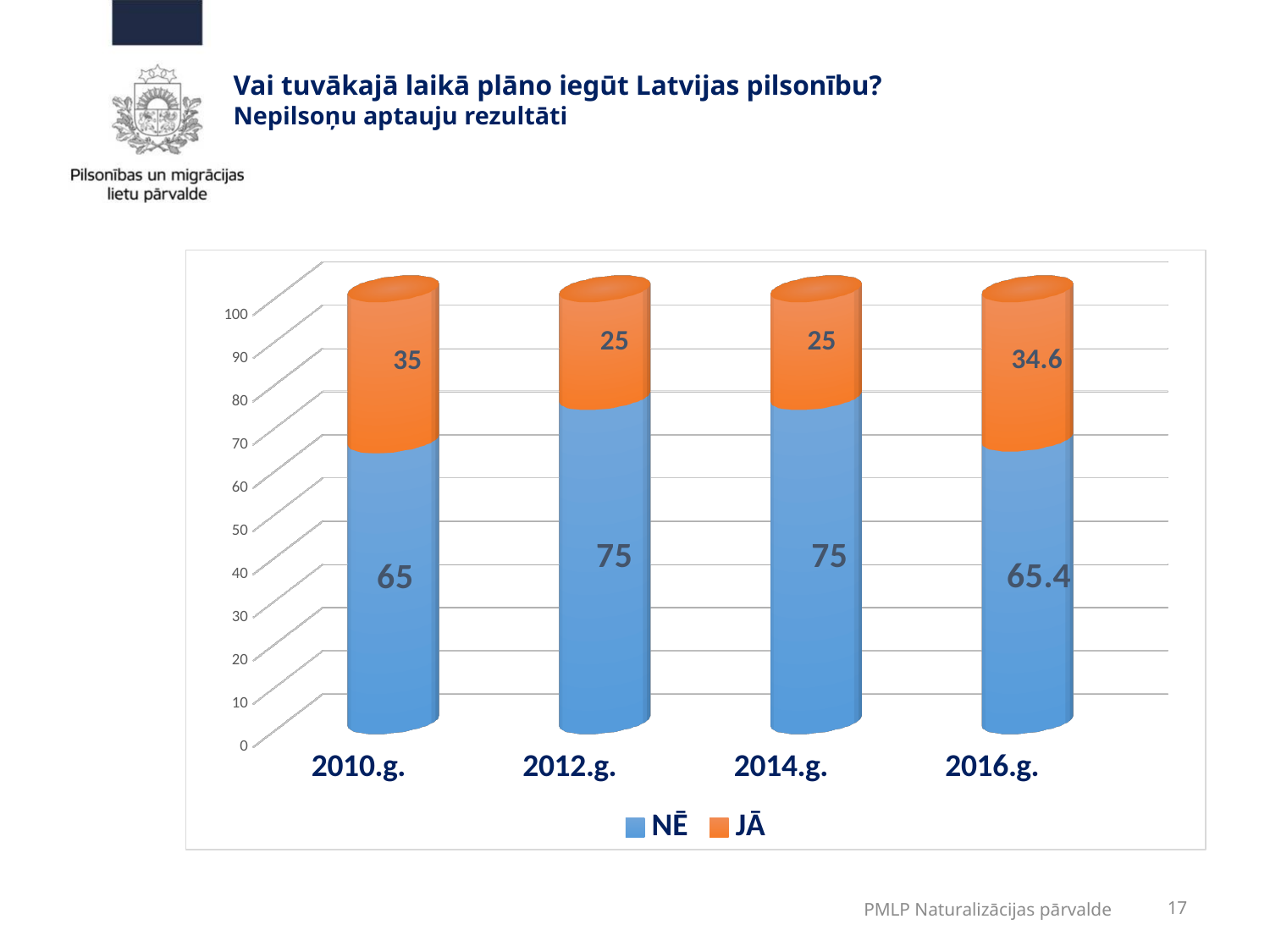
In which year is the NĒ value lowest? 2010.g. How many years are shown on the x axis? 4 What is the value for NĒ in 2016.g.? 65.4 What is the value for JĀ in 2012.g.? 25 In which year is the JĀ value highest? 2010.g. What is the value for NĒ in 2010.g.? 65 What kind of chart is shown on the slide? Stacked bar chart What is the difference between the NĒ and JĀ values in 2014.g.? 50 What is the total of the stacked bar for 2012.g.? 100 Which is larger in 2016.g., the NĒ value or the JĀ value? NĒ What is the value for JĀ in 2016.g.? 34.6 How many series does the legend list? 2